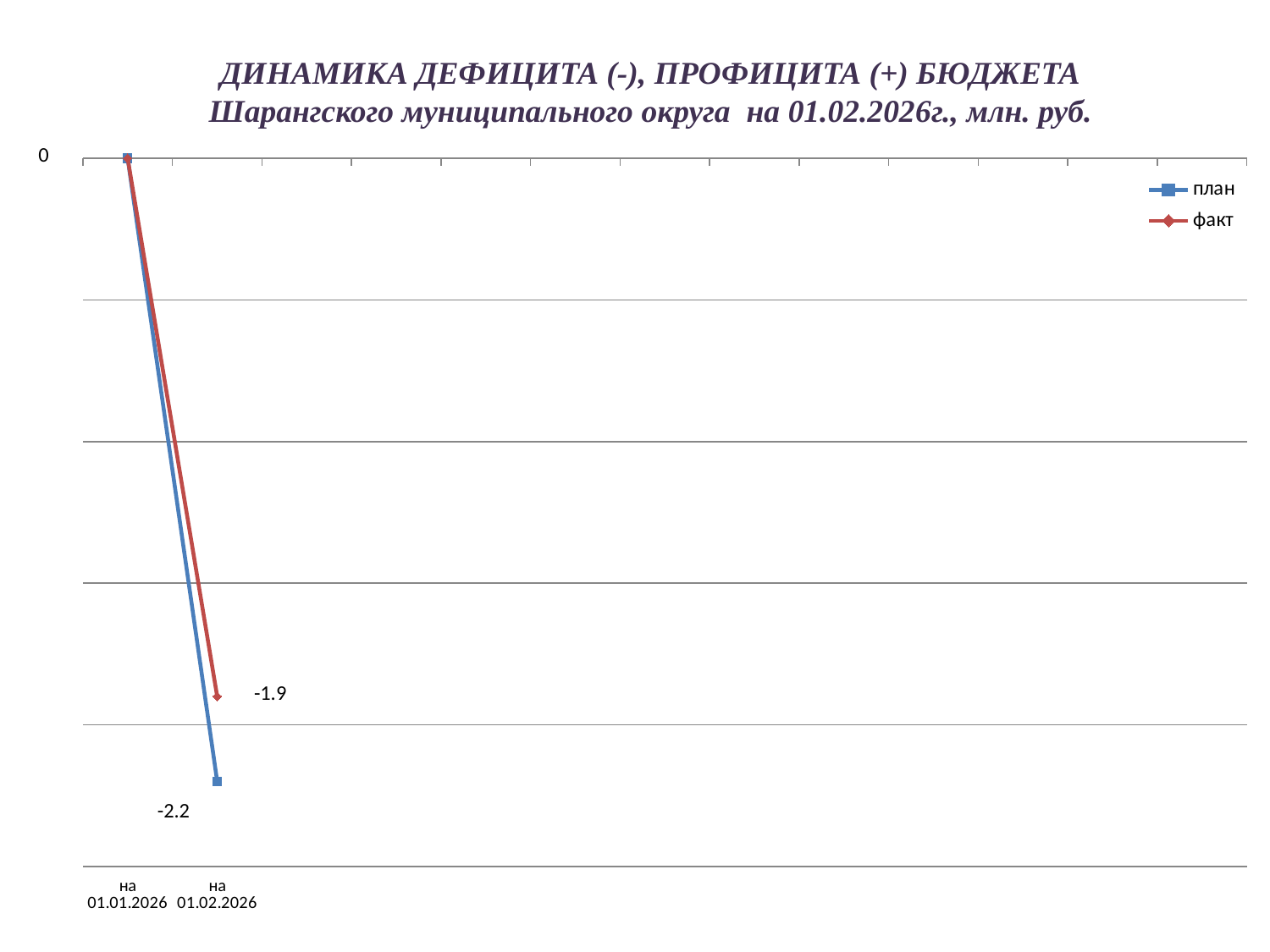
Which series has the lower value on 01.02.2026, план or факт? план How many series does the legend list? 2 Do the values of the план series rise or fall from 01.01.2026 to 01.02.2026? fall What is the difference between the план and факт values on 01.02.2026? 0.3 What is the value of the факт series on 01.01.2026? 0 What is the value of the план series on 01.01.2026? 0 What kind of chart is shown on the slide? line chart What are the names of the series in the legend? план, факт What is the value of the план series on 01.02.2026? -2.2 Which colour is used for the факт series? red What is the value of the факт series on 01.02.2026? -1.9 How many dates are shown on the x axis? 2